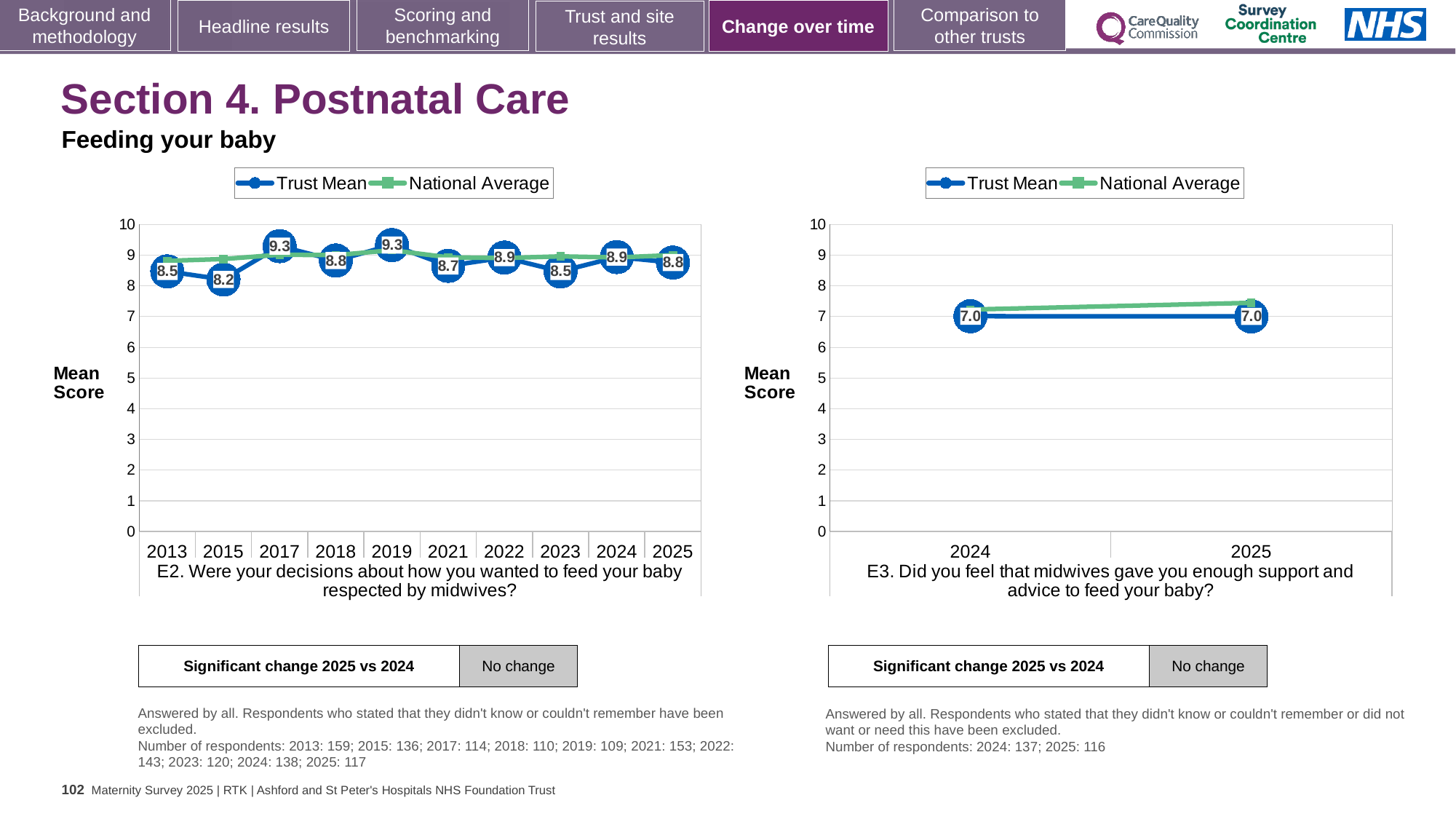
In the left chart (E2), which year has the higher Trust Mean score, 2019 or 2021? 2019 In the left chart (E2), what is the difference between the Trust Mean scores for 2017 and 2015? 1.1 In the right chart (E3), what is the Trust Mean score for 2024? 7.0 In the right chart (E3), how many years are plotted on the x axis? 2 In the right chart (E3), does the Trust Mean rise, fall or stay the same from 2024 to 2025? Stays the same What kind of chart is the right chart (E3)? Line chart In the left chart (E2), which year has the lowest Trust Mean score? 2015 In the left chart (E2), what is the Trust Mean score for 2025? 8.8 In the left chart (E2), what is the Trust Mean score for 2015? 8.2 In the left chart (E2), how many years are plotted on the x axis? 10 How many series does the legend of the left chart (E2) list? 2 In the right chart (E3), is the National Average value for 2025 greater or less than 8? less